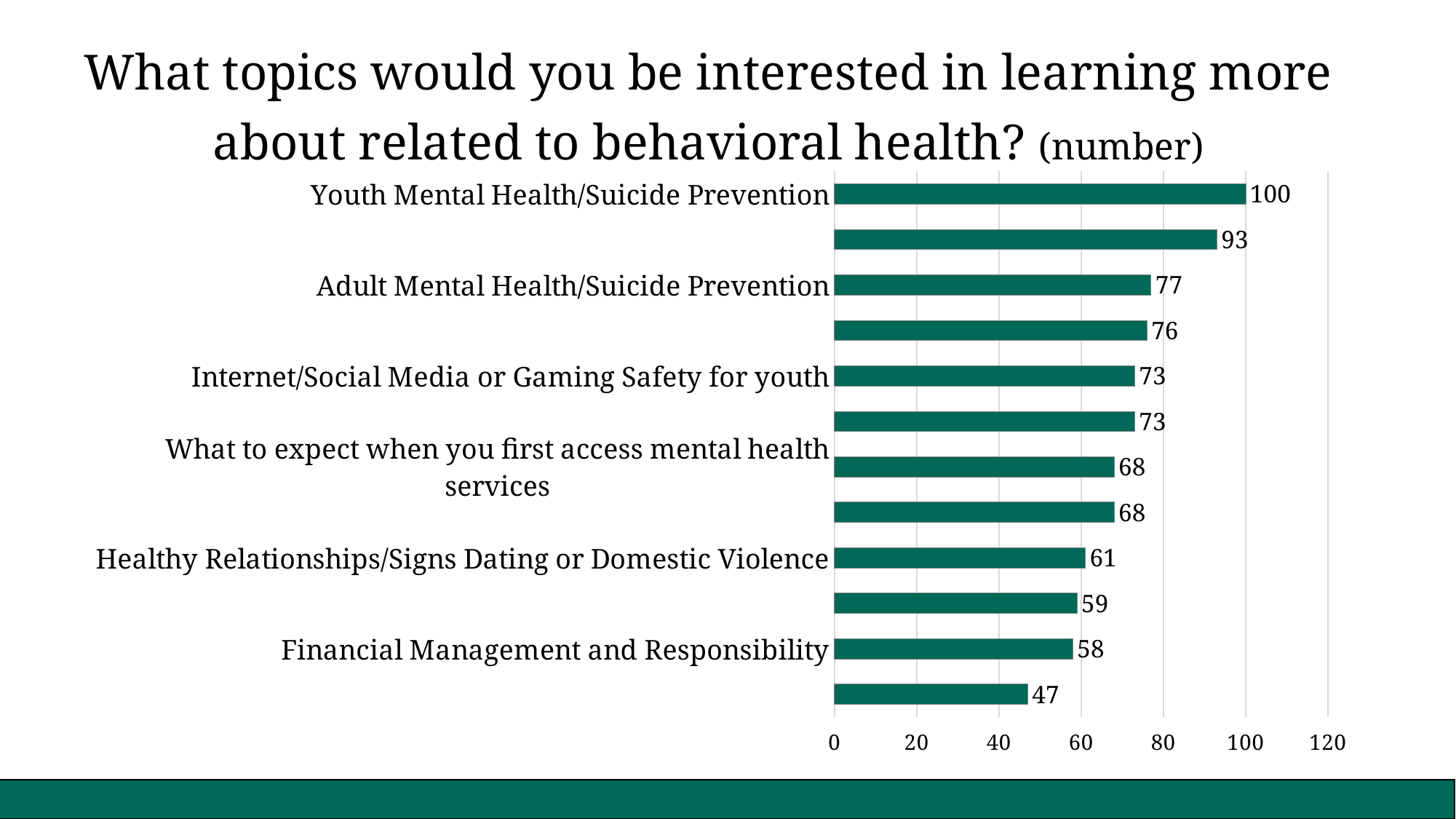
How many bars are plotted in the chart? 12 Which topic has the highest value? Youth Mental Health/Suicide Prevention What is the value for Adult Mental Health/Suicide Prevention? 77 What is the difference between the values for Youth Mental Health/Suicide Prevention and Adult Mental Health/Suicide Prevention? 23 What is the value for Internet/Social Media or Gaming Safety for youth? 73 What is the value for Healthy Relationships/Signs Dating or Domestic Violence? 61 Which is larger: Internet/Social Media or Gaming Safety for youth or Healthy Relationships/Signs Dating or Domestic Violence? Internet/Social Media or Gaming Safety for youth What is the value for Financial Management and Responsibility? 58 What kind of chart is shown on the slide? Bar chart What is the value for Youth Mental Health/Suicide Prevention? 100 What is the value for What to expect when you first access mental health services? 68 What is the smallest value labeled on any bar in the chart? 47